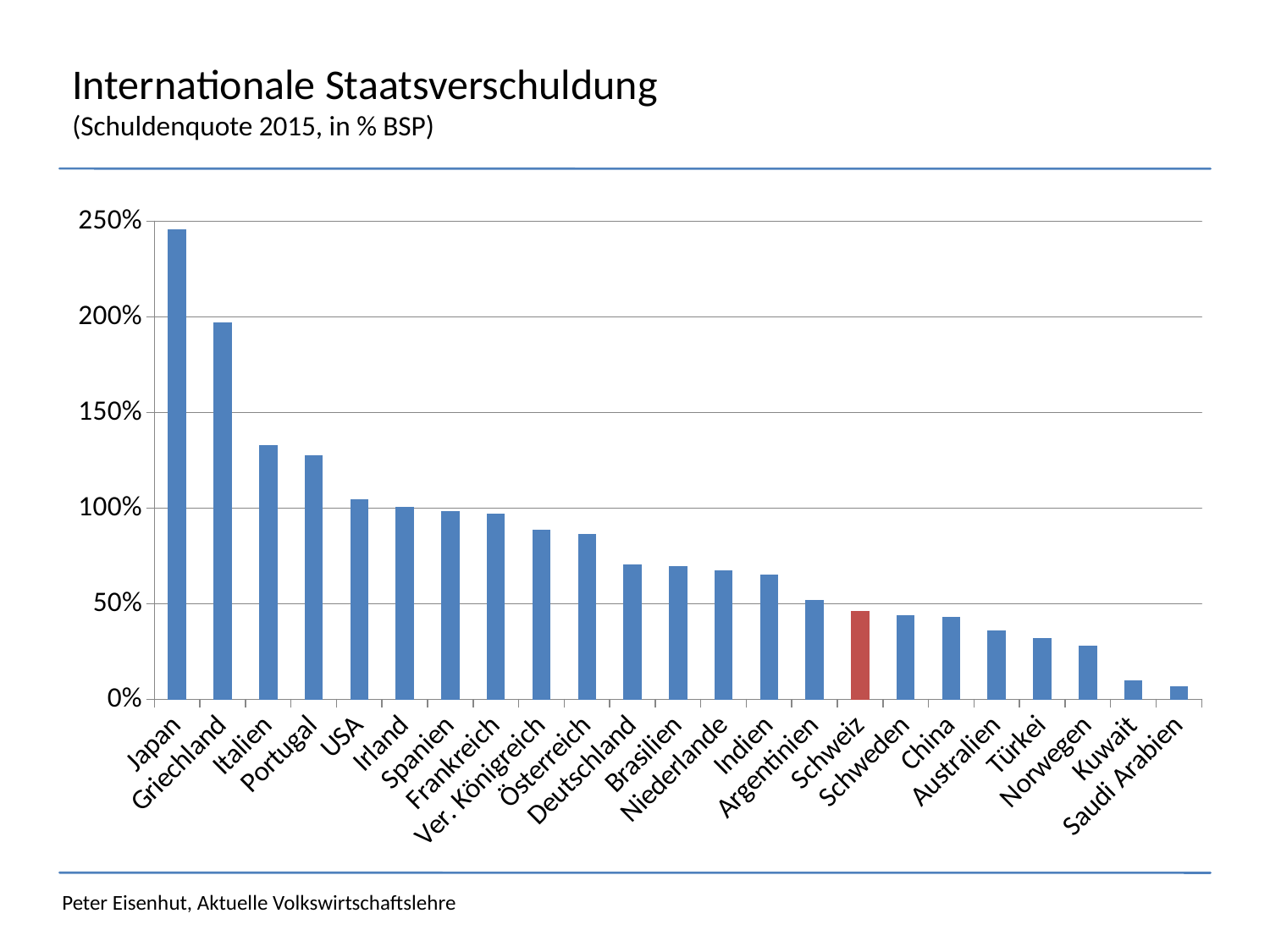
Which has the larger value, Japan or Griechland? Japan Is the value for Kuwait greater or less than 50%? less Do the values rise or fall from left to right along the x axis? fall Which country's bar is highlighted in a different colour (red) from the others? Schweiz What kind of chart is shown on the slide? bar chart Is the value for Japan greater or less than 200%? greater Is the value for Deutschland greater or less than 100%? less Which country has the lowest debt ratio in the chart? Saudi Arabien Which country has the highest debt ratio in the chart? Japan Which has the larger value, Deutschland or Schweiz? Deutschland How many countries are shown on the x axis of the chart? 23